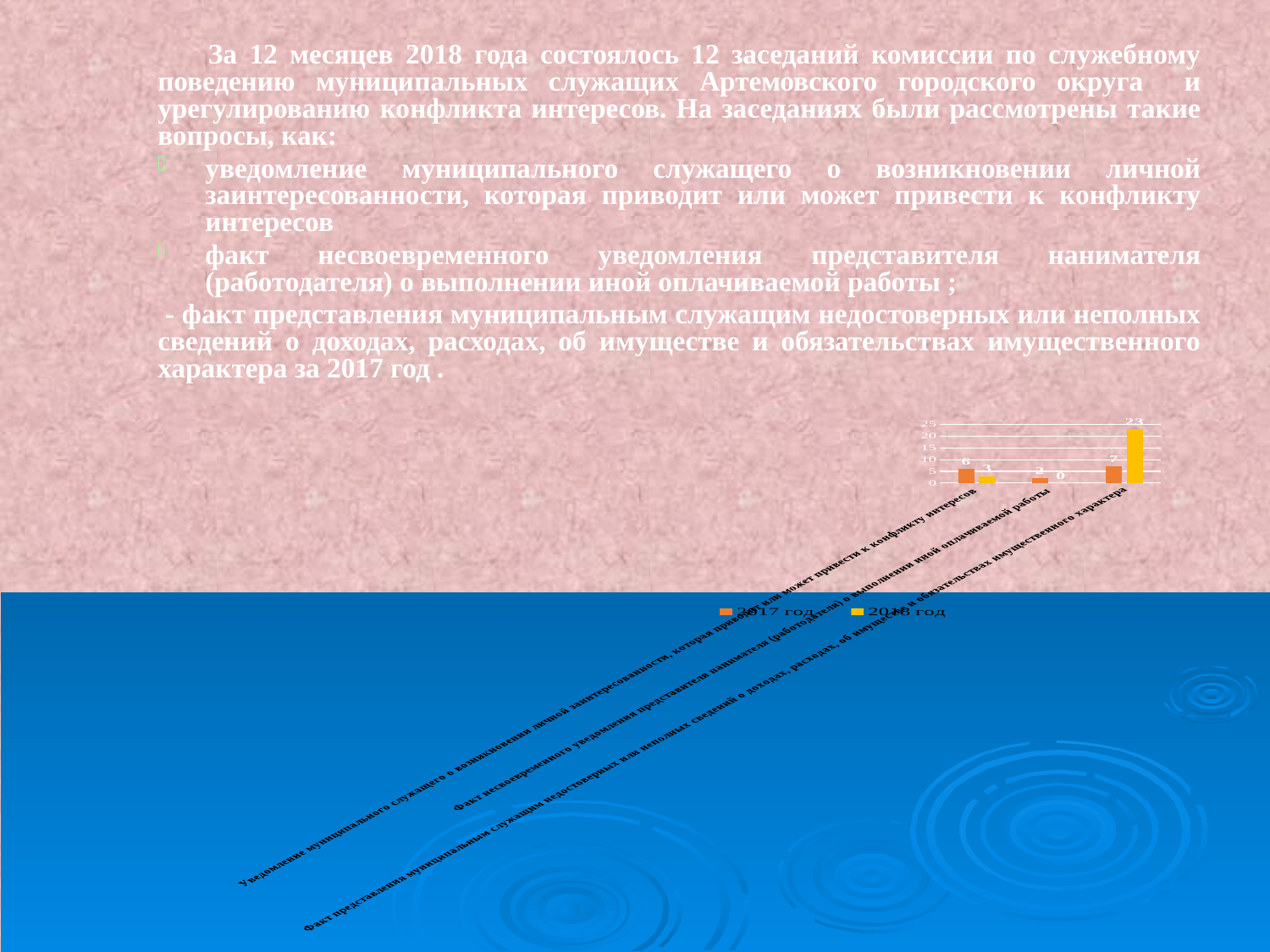
What is the value for 2018 год in the category about representing inaccurate or incomplete information on income, expenses, property and property obligations (Факт представления ... недостоверных или неполных сведений)? 23 Which legend entry is shown in yellow? 2018 год What is the value for 2017 год in the category about representing inaccurate or incomplete information on income (Факт представления ... недостоверных или неполных сведений)? 7 Which category has the lowest value for 2017 год? Факт несвоевременного уведомления представителя нанимателя (работодателя) о выполнении иной оплачиваемой работы What is the difference between the 2018 год and 2017 год values in the category about inaccurate or incomplete income information (Факт представления ...)? 16 What is the value for 2018 год in the category about untimely notification of the employer about other paid work (Факт несвоевременного уведомления ...)? 0 Which category has the highest value for 2018 год? Факт представления муниципальным служащим недостоверных или неполных сведений о доходах, расходах, об имуществе и обязательствах имущественного характера What type of chart is shown on the slide? bar chart How many categories are plotted in the chart? 3 What is the value for 2017 год in the category about notification of personal interest that may lead to a conflict of interest (Уведомление муниципального служащего ...)? 6 How many series does the chart legend list? 2 In the category about notification of personal interest (Уведомление муниципального служащего ...), which series has the larger value, 2017 год or 2018 год? 2017 год